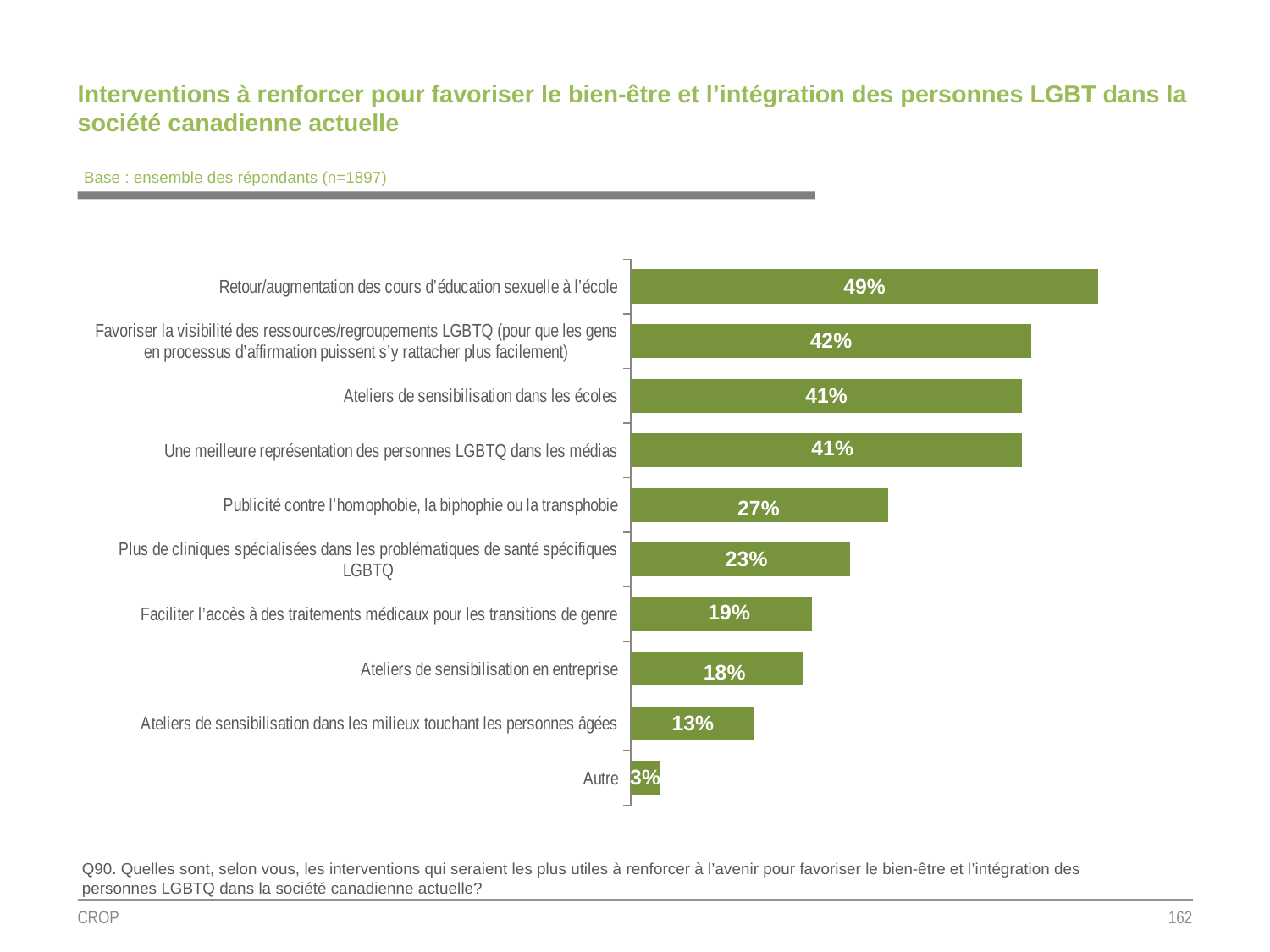
What kind of chart is shown on the slide? Bar chart Which category has the lowest percentage? Autre What percentage of respondents chose "Retour/augmentation des cours d'éducation sexuelle à l'école"? 49% What is the value for "Une meilleure représentation des personnes LGBTQ dans les médias"? 41% Which is larger: the value for "Publicité contre l'homophobie, la biphophie ou la transphobie" or for "Ateliers de sensibilisation dans les milieux touchant les personnes âgées"? Publicité contre l'homophobie, la biphophie ou la transphobie What is the value for "Publicité contre l'homophobie, la biphophie ou la transphobie"? 27% What is the value for "Ateliers de sensibilisation en entreprise"? 18% Which intervention has the highest percentage? Retour/augmentation des cours d'éducation sexuelle à l'école What is the base (number of respondents) stated for the chart? n=1897 What is the difference between "Plus de cliniques spécialisées dans les problématiques de santé spécifiques LGBTQ" and "Faciliter l'accès à des traitements médicaux pour les transitions de genre"? 4% What is the difference between the values for "Retour/augmentation des cours d'éducation sexuelle à l'école" and "Ateliers de sensibilisation dans les écoles"? 8% How many categories are shown in the chart? 10